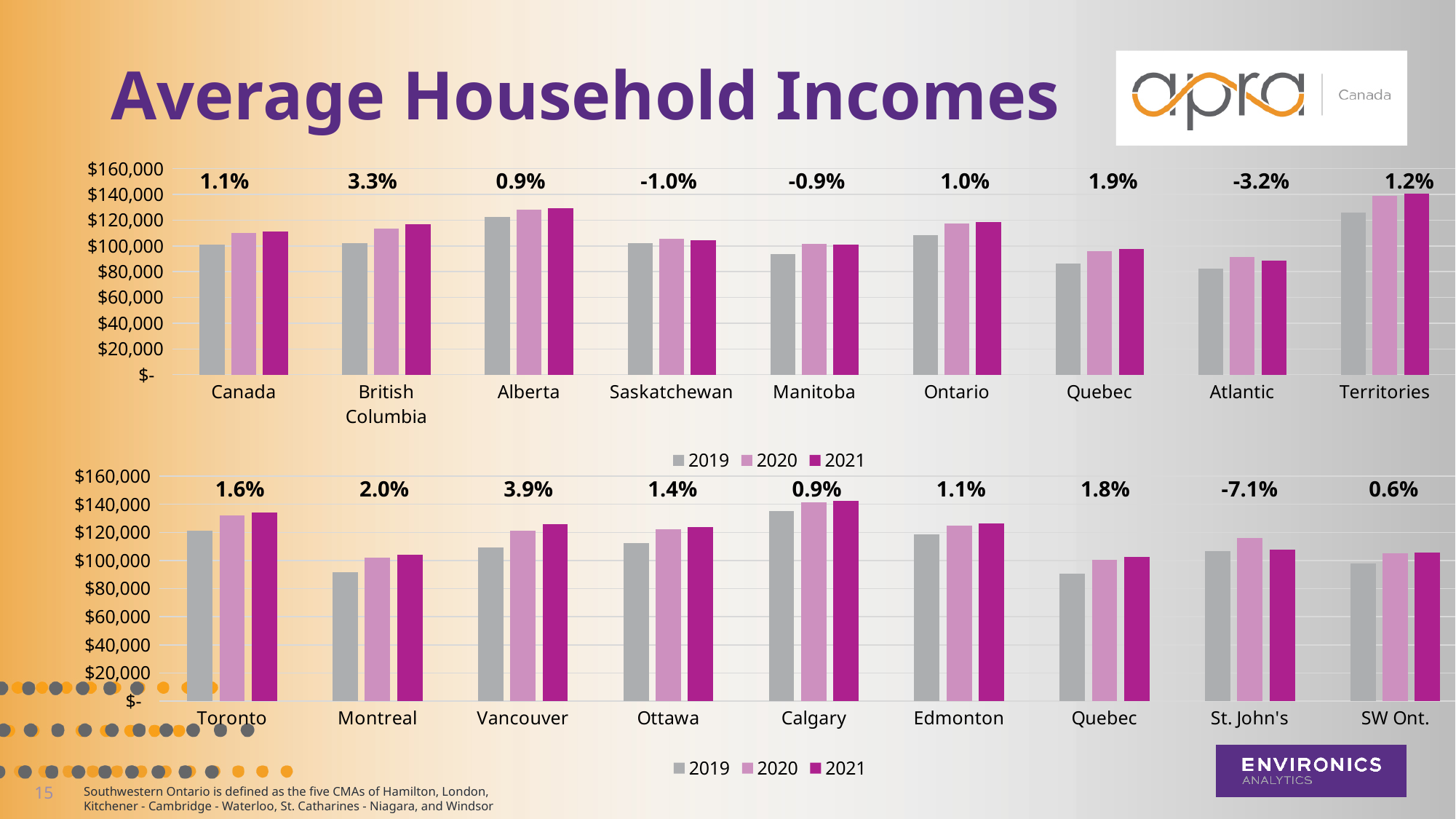
In the top chart, what percentage label is shown above British Columbia? 3.3% How many categories are shown on the x axis of the top chart? 9 In the bottom chart, is the 2021 value for Toronto greater or less than $120,000? greater How many series does the legend of the bottom chart list? 3 In the bottom chart, what percentage label is shown above St. John's? -7.1% In the bottom chart, which is larger: the 2019 value for Calgary or the 2019 value for Ottawa? Calgary In the bottom chart, what percentage label is shown above Vancouver? 3.9% In the top chart, which category has the highest 2021 bar? Territories In the top chart, what percentage label is shown above Atlantic? -3.2% What type of chart is the top chart on the slide? bar chart In the bottom chart, which category has the highest 2021 bar? Calgary In the top chart, is the 2019 value for Atlantic greater or less than $100,000? less